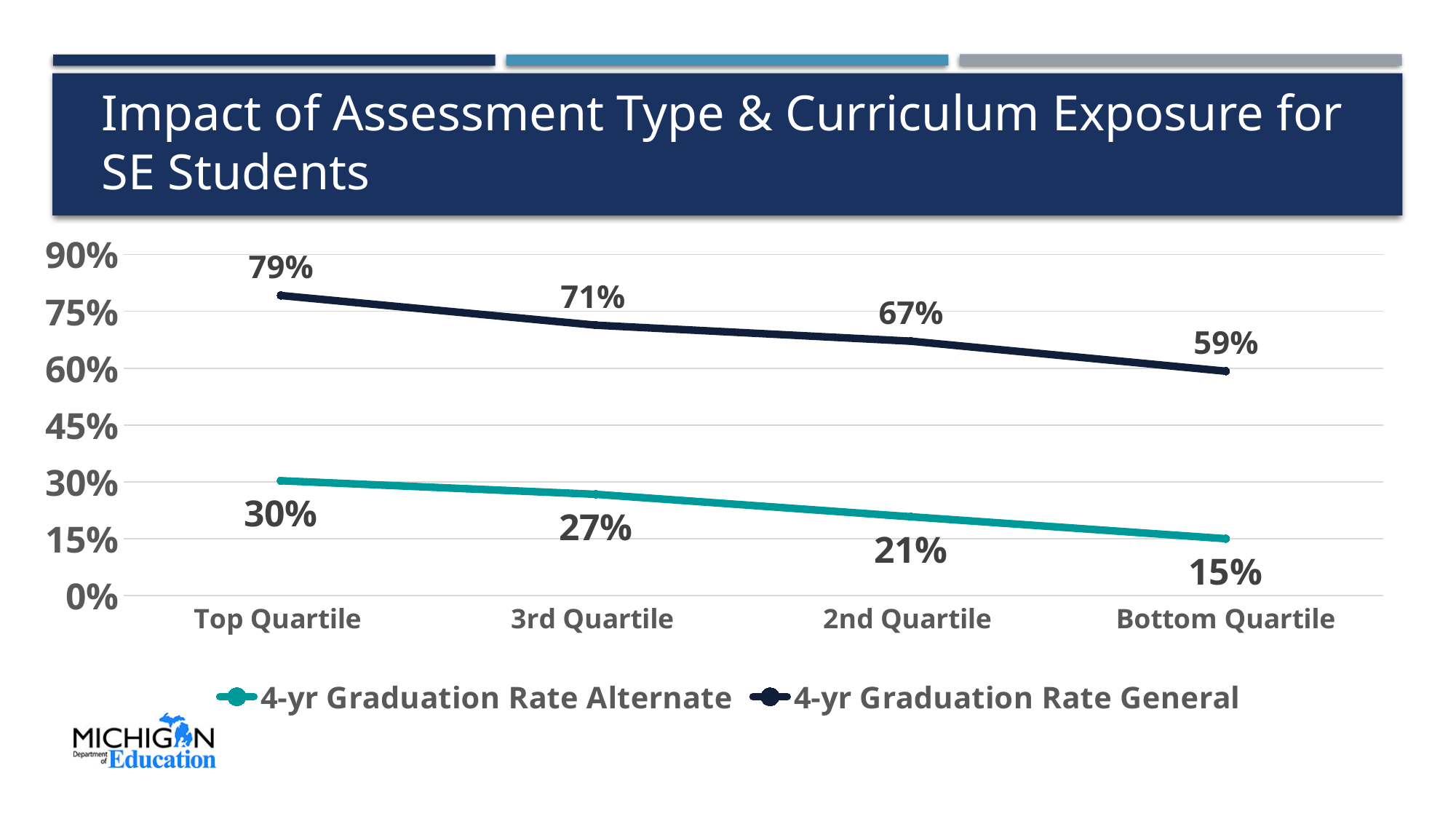
Which is larger for the 2nd Quartile: the 4-yr Graduation Rate General or the 4-yr Graduation Rate Alternate? 4-yr Graduation Rate General Do the 4-yr Graduation Rate General values rise or fall from the Top Quartile to the Bottom Quartile? Fall What is the 4-yr Graduation Rate General for the Top Quartile? 79% What is the 4-yr Graduation Rate Alternate for the 3rd Quartile? 27% What is the 4-yr Graduation Rate Alternate for the 2nd Quartile? 21% Which quartile has the highest 4-yr Graduation Rate General? Top Quartile What is the 4-yr Graduation Rate General for the Bottom Quartile? 59% How many quartile categories are shown on the x axis? 4 What kind of chart is shown on the slide? Line chart Which quartile has the lowest 4-yr Graduation Rate Alternate? Bottom Quartile How many series does the legend list? 2 What is the difference between the 4-yr Graduation Rate General and the 4-yr Graduation Rate Alternate for the Top Quartile? 49%